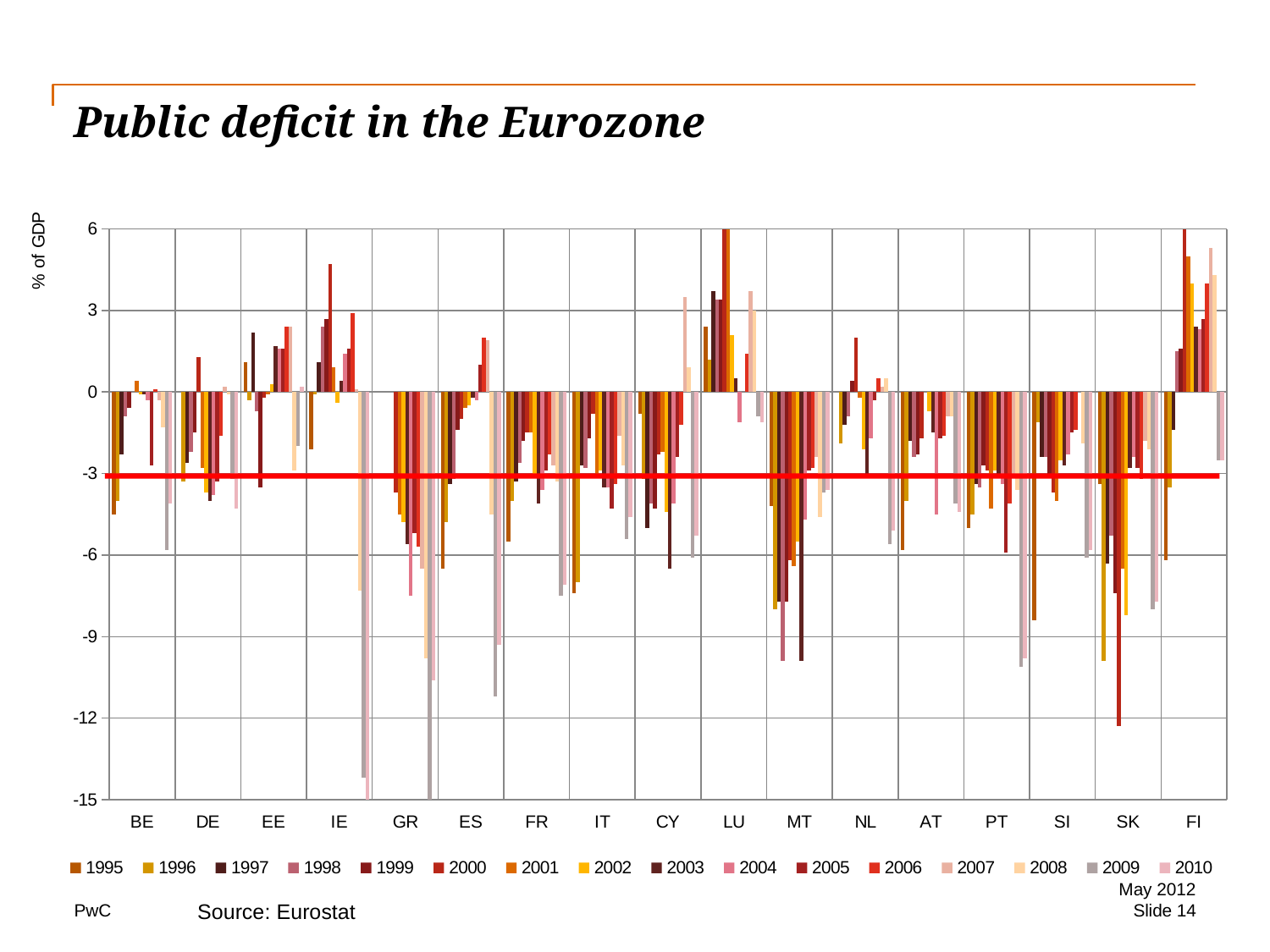
Is the value for LU in 2007 greater or less than 3? greater How many countries are shown along the x axis of the chart? 17 Is the value for MT in 2003 greater or less than -9? less What is the title of the slide's chart? Public deficit in the Eurozone What kind of chart is shown on the slide? bar chart What value does the horizontal red line on the chart mark? -3 Is the value for SK in 2000 greater or less than -9? less How many series (years) does the legend list? 16